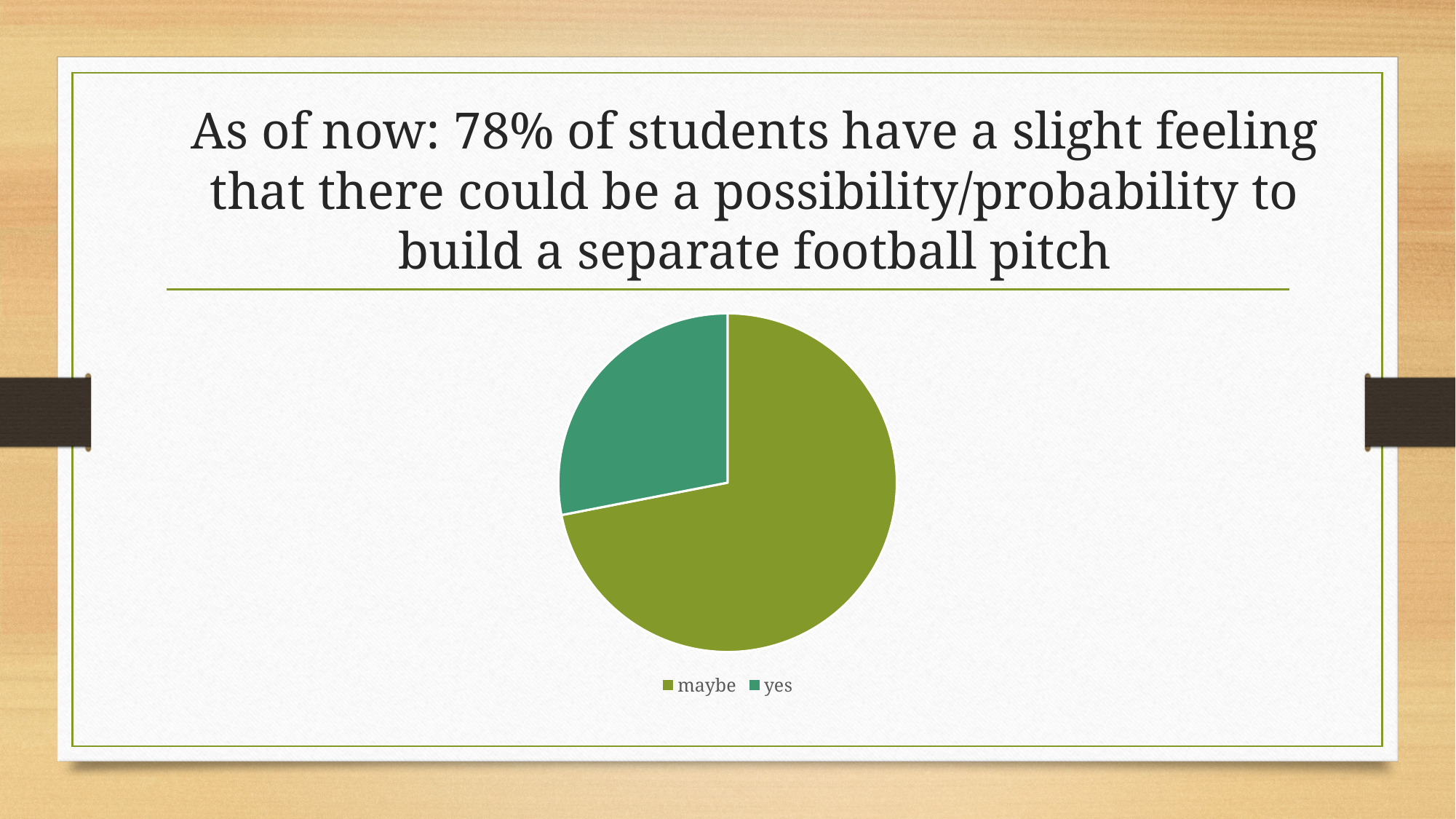
Which slice is larger in the pie chart, "maybe" or "yes"? maybe Which slice of the pie chart is the smallest? yes How many entries does the legend of the pie chart list? 2 How many slices does the pie chart have? 2 What colour is the "yes" slice in the pie chart? teal Which slice of the pie chart is the largest? maybe What kind of chart is shown on the slide? pie chart What are the two categories listed in the legend of the pie chart? maybe and yes